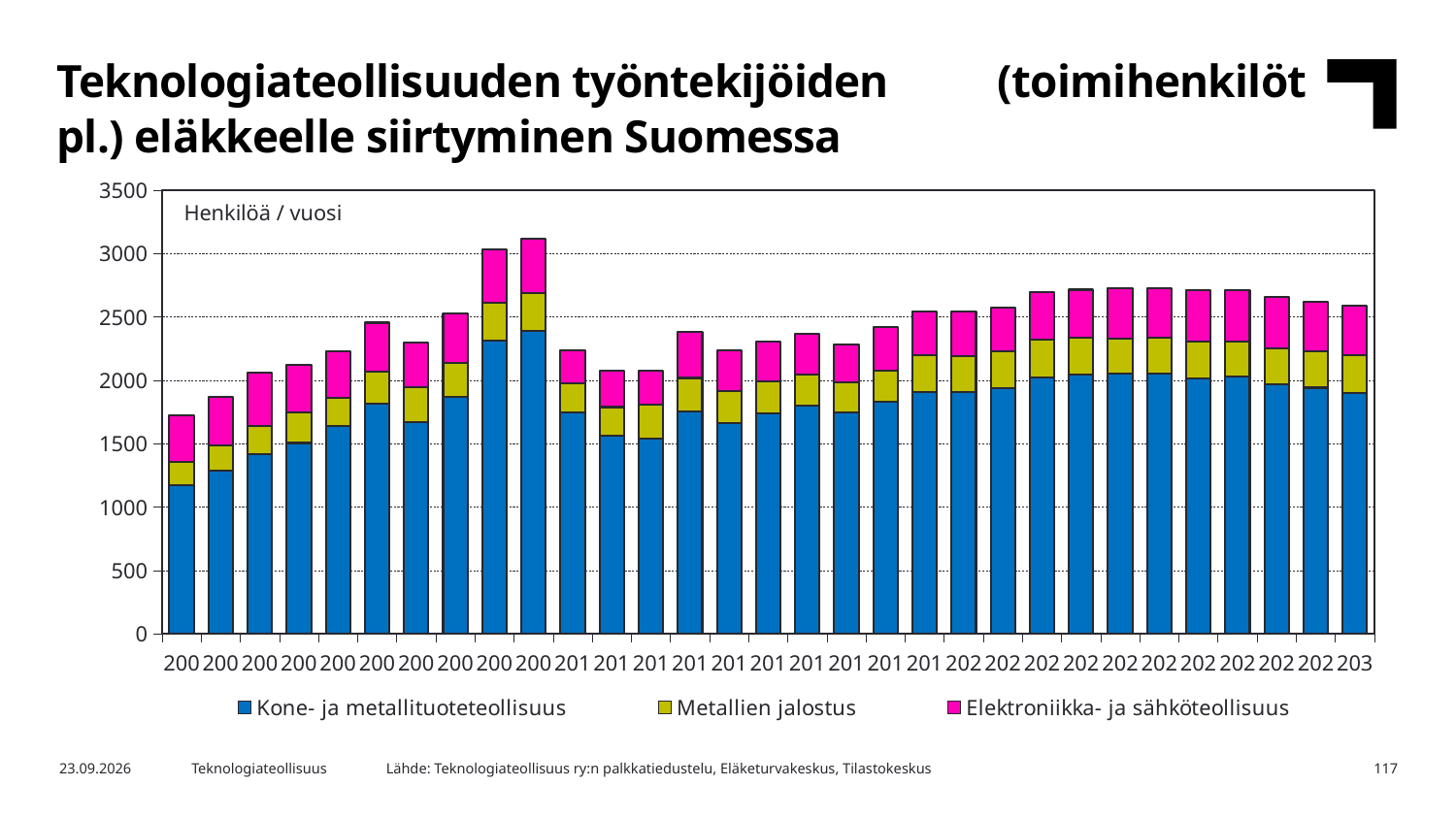
Which series is shown in blue in the legend? Kone- ja metallituoteteollisuus How many series does the legend list? 3 Is the total of the rightmost bar greater or less than 3000? less Is the total of the tallest bar greater or less than 3000? greater Is the Kone- ja metallituoteteollisuus segment of the leftmost bar greater or less than 1000? greater What is the highest value shown on the vertical axis? 3500 How many bars are plotted in the chart? 31 Do the bar totals generally rise or fall across the first ten bars from the left? rise Which bar has the larger total, the leftmost bar or the rightmost bar? The rightmost bar What kind of chart is shown on the slide? Stacked bar chart What unit label is shown inside the plot area of the chart? Henkilöä / vuosi